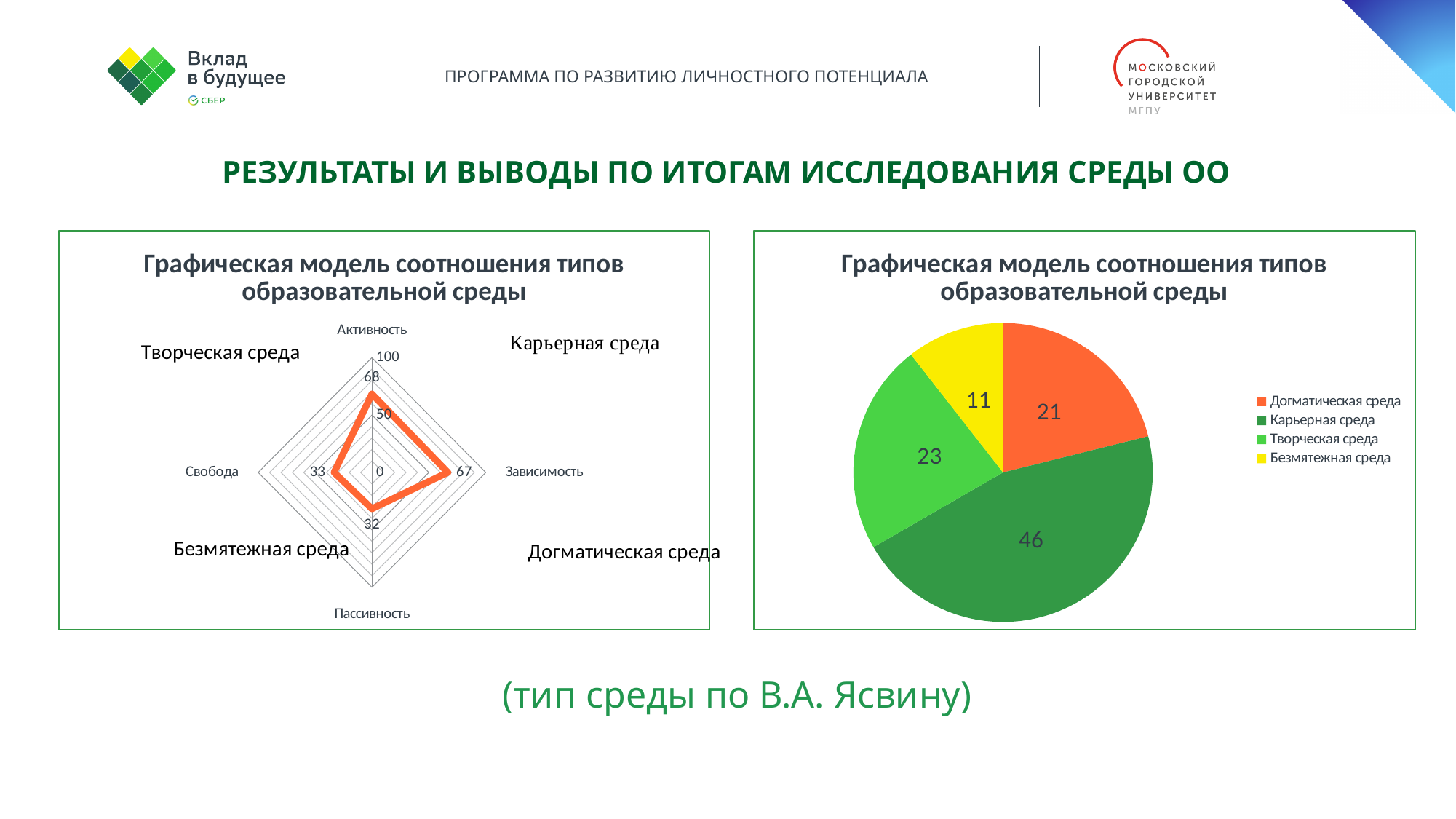
On the left chart, which axis has the lowest value? Пассивность On the left chart, what is the value for Активность? 68 On the left chart, what is the difference between the values for Активность and Пассивность? 36 On the right pie chart, what is the value for Карьерная среда? 46 On the right pie chart, which category has the largest slice? Карьерная среда On the right pie chart, which is larger: Догматическая среда or Творческая среда? Творческая среда On the left chart, what is the value for Пассивность? 32 On the left chart, which axis has the highest value? Активность How many categories does the legend of the right pie chart list? 4 What kind of chart is the left chart? Radar chart On the left chart, what is the value for Зависимость? 67 On the right pie chart, what is the value for Безмятежная среда? 11